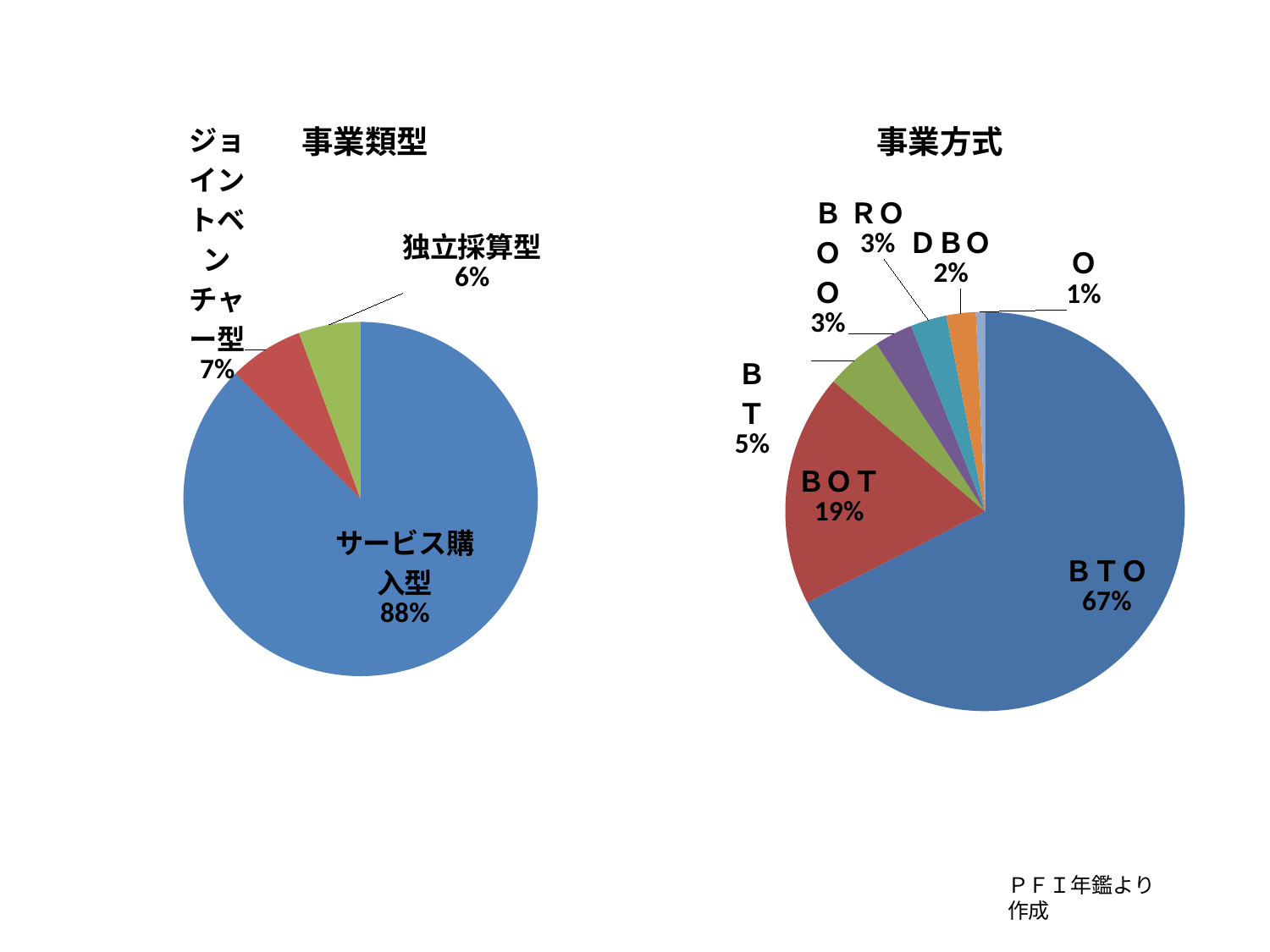
In the 事業方式 chart, which category has the smallest share? Ｏ In the 事業方式 chart, what share does ＢＯＴ have? 19% In the 事業類型 chart, what share does サービス購入型 have? 88% In the 事業類型 chart, which category has the smallest share? 独立採算型 What kind of chart is the 事業方式 chart? Pie chart In the 事業類型 chart, what share does ジョイントベンチャー型 have? 7% In the 事業方式 chart, what is the difference between the shares of ＢＴＯ and ＢＯＴ? 48% In the 事業方式 chart, what share does ＢＴ have? 5% In the 事業方式 chart, which category has the largest share? ＢＴＯ In the 事業類型 chart, how many categories are shown? 3 In the 事業類型 chart, what share does 独立採算型 have? 6% In the 事業方式 chart, what share does ＢＴＯ have? 67%